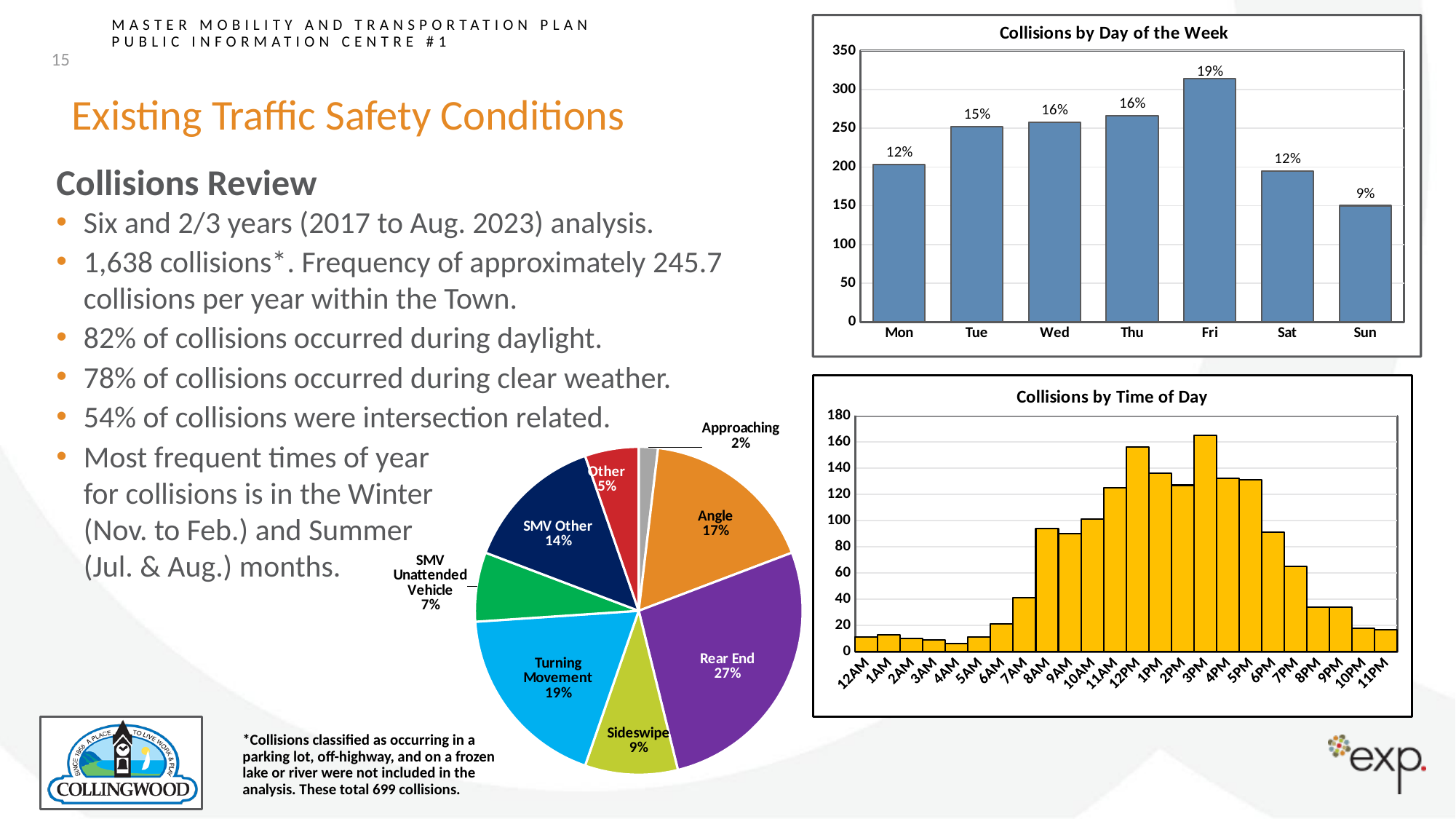
How many days are shown in the 'Collisions by Day of the Week' chart? 7 In the pie chart at the bottom of the slide, what share of collisions is Rear End? 27% In the 'Collisions by Time of Day' chart, is the value for 12PM greater or less than 140? greater In the 'Collisions by Day of the Week' chart, which day has the highest number of collisions? Fri In the 'Collisions by Time of Day' chart, which hour has the lowest number of collisions? 4AM In the 'Collisions by Day of the Week' chart, is the value for Fri greater or less than 300? greater In the pie chart at the bottom of the slide, which collision type has the largest slice? Rear End In the 'Collisions by Time of Day' chart, which hour has the highest number of collisions? 3PM In the 'Collisions by Day of the Week' chart, what percentage is shown for Fri? 19% In the 'Collisions by Day of the Week' chart, what is the difference between the percentages shown for Fri and Sun? 10% In the 'Collisions by Day of the Week' chart, which day has the lowest number of collisions? Sun What kind of chart is 'Collisions by Day of the Week'? bar chart